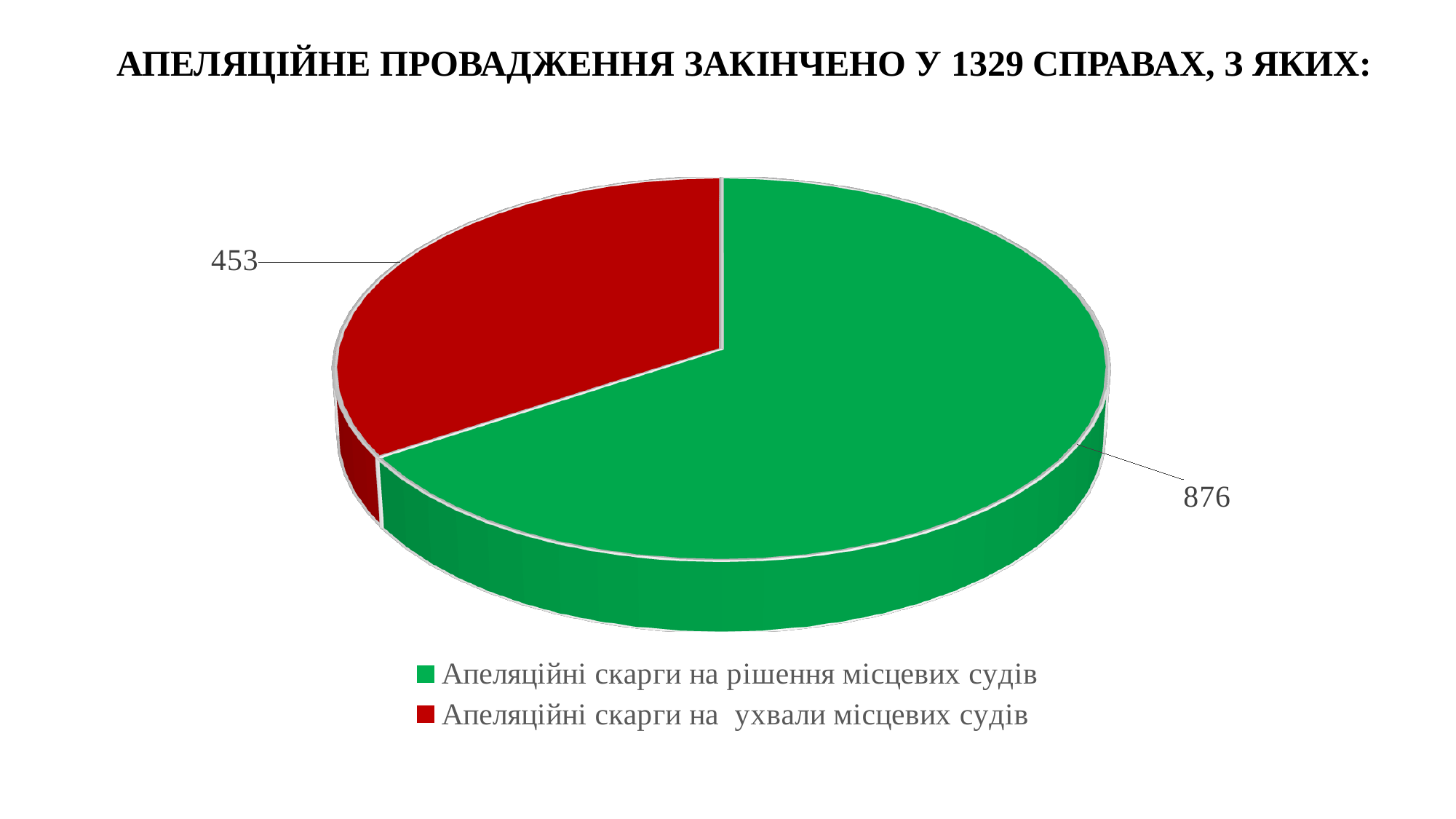
What is the title of the chart? АПЕЛЯЦІЙНЕ ПРОВАДЖЕННЯ ЗАКІНЧЕНО У 1329 СПРАВАХ, З ЯКИХ: Which is larger: the value for 'Апеляційні скарги на рішення місцевих судів' or for 'Апеляційні скарги на ухвали місцевих судів'? Апеляційні скарги на рішення місцевих судів How many slices does the pie chart have? 2 What type of chart is shown on the slide? Pie chart Which category has the smallest slice of the pie? Апеляційні скарги на ухвали місцевих судів What colour is the slice for 'Апеляційні скарги на ухвали місцевих судів'? Red What share of the pie does 'Апеляційні скарги на рішення місцевих судів' represent, to one decimal place? 65.9% What is the total of the two slices in the pie chart? 1329 What is the difference between the values for 'Апеляційні скарги на рішення місцевих судів' and 'Апеляційні скарги на ухвали місцевих судів'? 423 What is the value for 'Апеляційні скарги на рішення місцевих судів'? 876 What is the value for 'Апеляційні скарги на ухвали місцевих судів'? 453 Which category has the largest slice of the pie? Апеляційні скарги на рішення місцевих судів